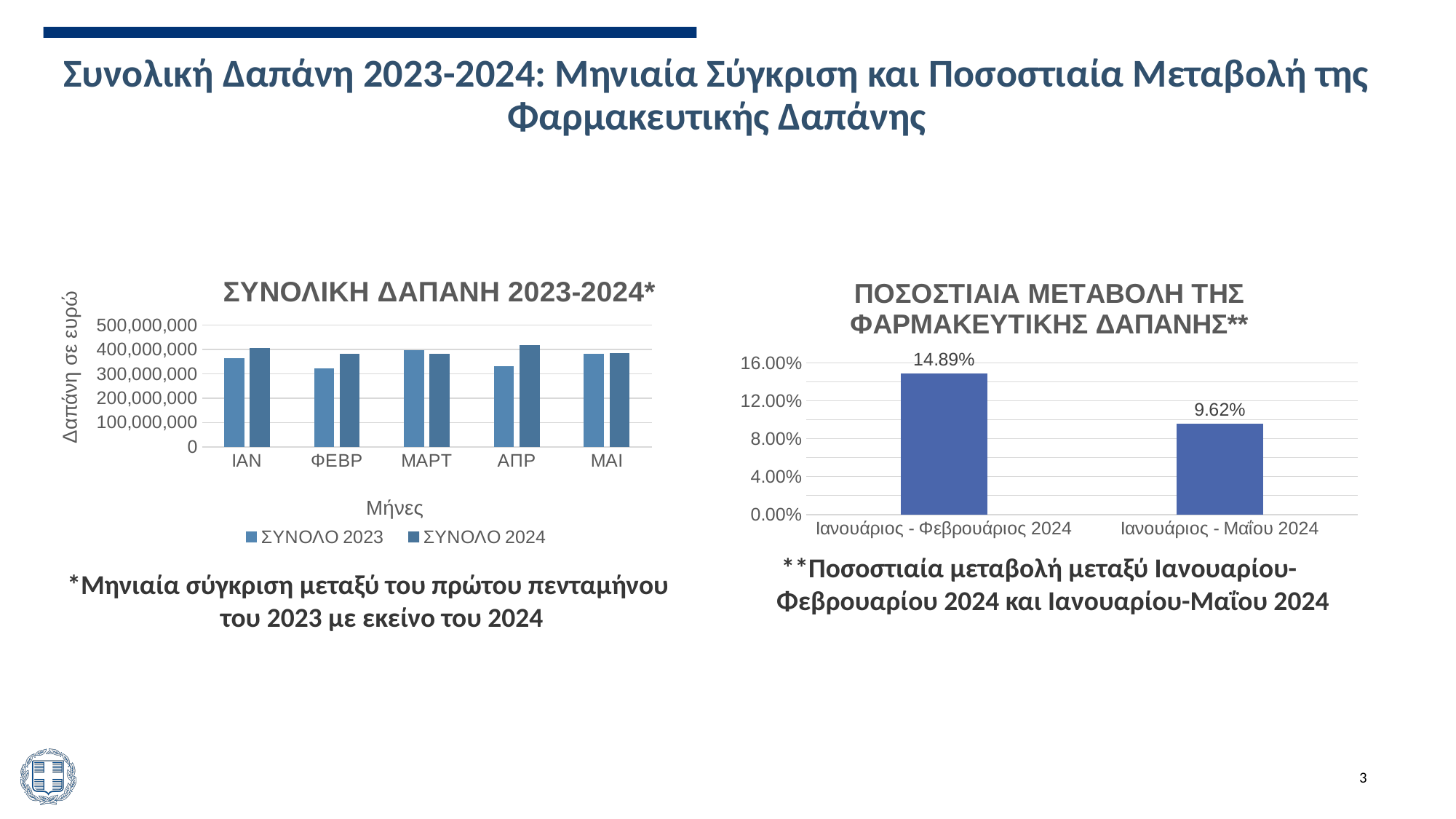
In the chart titled ΣΥΝΟΛΙΚΗ ΔΑΠΑΝΗ 2023-2024*, how many months are shown on the x axis? 5 What kind of chart is the one on the right of the slide? Bar chart In the chart titled ΠΟΣΟΣΤΙΑΙΑ ΜΕΤΑΒΟΛΗ ΤΗΣ ΦΑΡΜΑΚΕΥΤΙΚΗΣ ΔΑΠΑΝΗΣ**, what is the difference between the two values? 5.27% In the chart titled ΠΟΣΟΣΤΙΑΙΑ ΜΕΤΑΒΟΛΗ ΤΗΣ ΦΑΡΜΑΚΕΥΤΙΚΗΣ ΔΑΠΑΝΗΣ**, how many bars are plotted? 2 In the chart titled ΣΥΝΟΛΙΚΗ ΔΑΠΑΝΗ 2023-2024*, is the ΣΥΝΟΛΟ 2023 value for ΑΠΡ greater or less than 300,000,000? greater In the chart titled ΣΥΝΟΛΙΚΗ ΔΑΠΑΝΗ 2023-2024*, how many series does the legend list? 2 In the chart titled ΣΥΝΟΛΙΚΗ ΔΑΠΑΝΗ 2023-2024*, for ΑΠΡ, which is larger: ΣΥΝΟΛΟ 2023 or ΣΥΝΟΛΟ 2024? ΣΥΝΟΛΟ 2024 In the chart titled ΠΟΣΟΣΤΙΑΙΑ ΜΕΤΑΒΟΛΗ ΤΗΣ ΦΑΡΜΑΚΕΥΤΙΚΗΣ ΔΑΠΑΝΗΣ**, what is the value for Ιανουάριος - Μαΐου 2024? 9.62% In the chart titled ΠΟΣΟΣΤΙΑΙΑ ΜΕΤΑΒΟΛΗ ΤΗΣ ΦΑΡΜΑΚΕΥΤΙΚΗΣ ΔΑΠΑΝΗΣ**, what is the value for Ιανουάριος - Φεβρουάριος 2024? 14.89% In the chart titled ΠΟΣΟΣΤΙΑΙΑ ΜΕΤΑΒΟΛΗ ΤΗΣ ΦΑΡΜΑΚΕΥΤΙΚΗΣ ΔΑΠΑΝΗΣ**, which category has the highest value? Ιανουάριος - Φεβρουάριος 2024 In the chart titled ΣΥΝΟΛΙΚΗ ΔΑΠΑΝΗ 2023-2024*, what is the label of the y axis? Δαπάνη σε ευρώ In the chart titled ΣΥΝΟΛΙΚΗ ΔΑΠΑΝΗ 2023-2024*, is the ΣΥΝΟΛΟ 2023 value for ΦΕΒΡ greater or less than 400,000,000? less